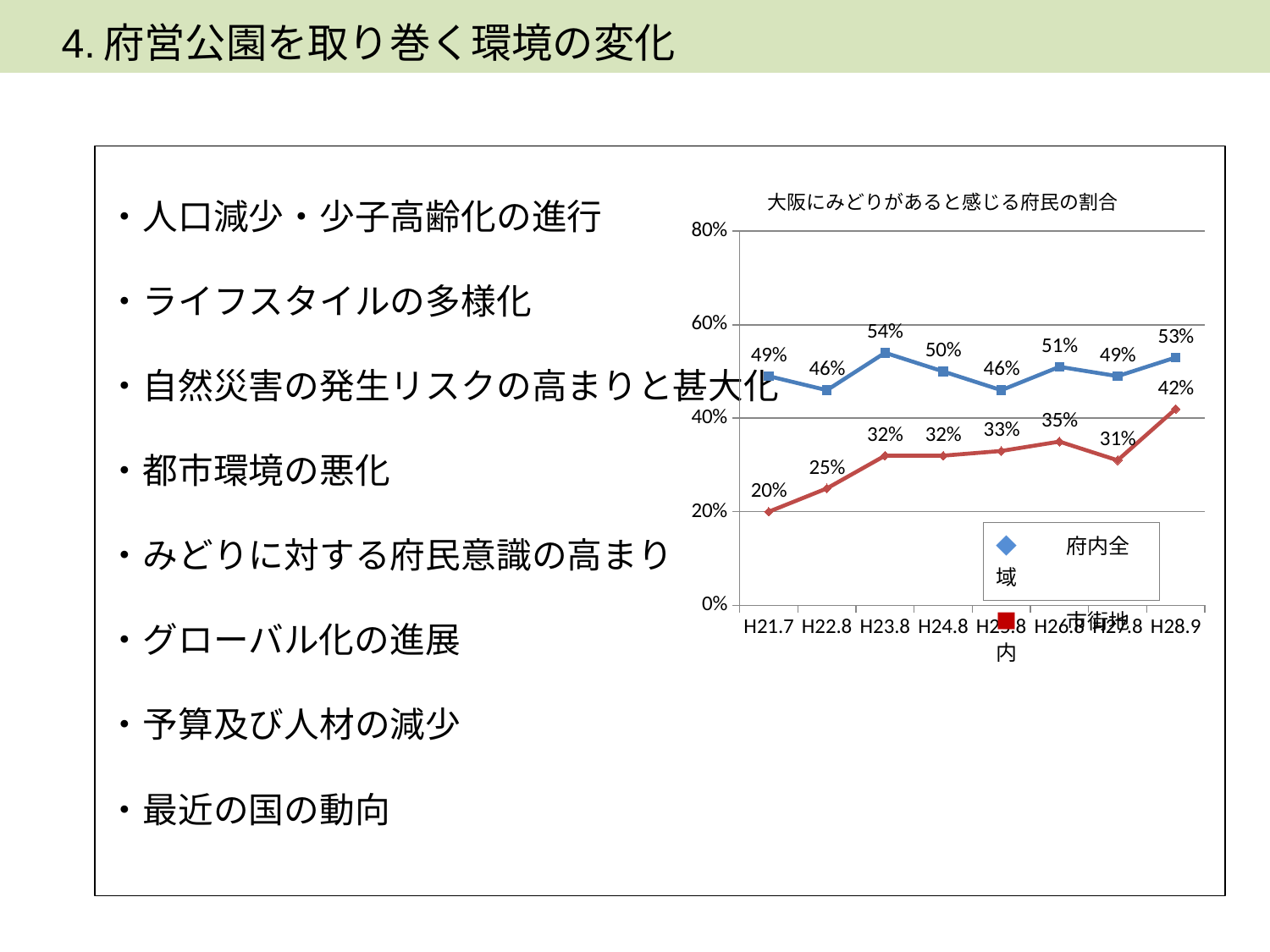
What is the value of the 府内全域 (blue) series at H23.8? 54% At which x-axis point is the red (市街地内) series lowest? H21.7 What is the title of the chart? 大阪にみどりがあると感じる府民の割合 Does the red (市街地内) series generally rise or fall from H21.7 to H28.9? rise Which series has the larger value at H26.8, 府内全域 (blue) or the red (市街地内) series? 府内全域 What is the difference between the 府内全域 (blue) value and the red (市街地内) value at H28.9? 11% What is the value of the red (市街地内) series at H21.7? 20% Is the value of the 府内全域 (blue) series at H23.8 greater or less than 60%? less How many series does the chart's legend list? 2 At which x-axis point is the red (市街地内) series highest? H28.9 How many points along the x axis does the chart have? 8 What type of chart is shown on the slide? line chart